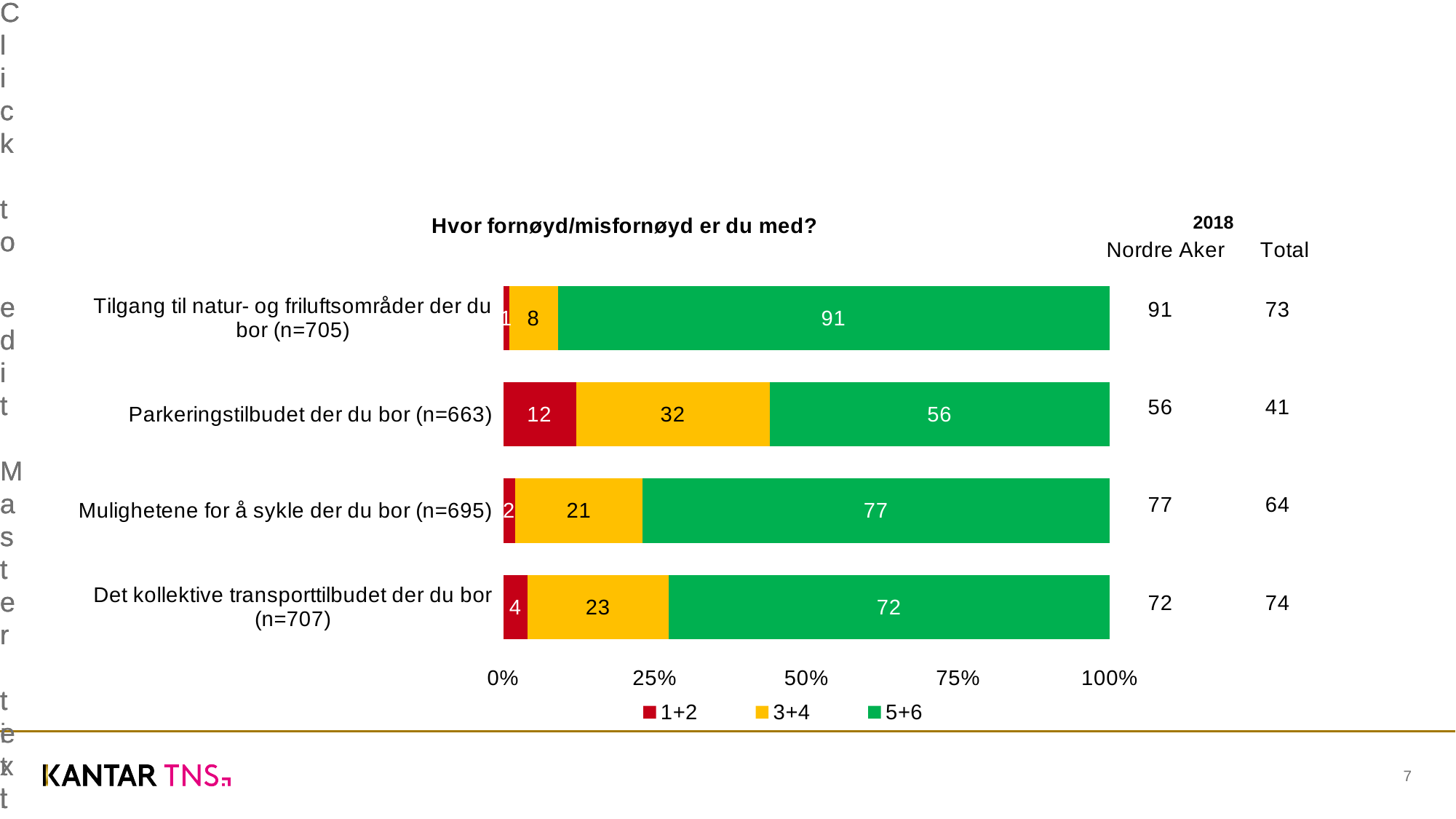
What is the value of the 3+4 series for "Mulighetene for å sykle der du bor (n=695)"? 21 Which category has the lowest value for the 5+6 series? Parkeringstilbudet der du bor (n=663) What is the difference between the 3+4 values for "Parkeringstilbudet der du bor (n=663)" and "Tilgang til natur- og friluftsområder der du bor (n=705)"? 24 Which category has the highest value for the 5+6 series? Tilgang til natur- og friluftsområder der du bor (n=705) What is the value of the 1+2 series for "Det kollektive transporttilbudet der du bor (n=707)"? 4 What kind of chart is shown on the slide? Stacked bar chart How many series does the legend list? 3 What is the title of the chart? Hvor fornøyd/misfornøyd er du med? Which is larger: the 5+6 value for "Mulighetene for å sykle der du bor (n=695)" or for "Det kollektive transporttilbudet der du bor (n=707)"? Mulighetene for å sykle der du bor (n=695) How many categories are shown in the chart? 4 What is the value of the 5+6 series for "Parkeringstilbudet der du bor (n=663)"? 56 What is the total of the stacked bar for "Parkeringstilbudet der du bor (n=663)"? 100